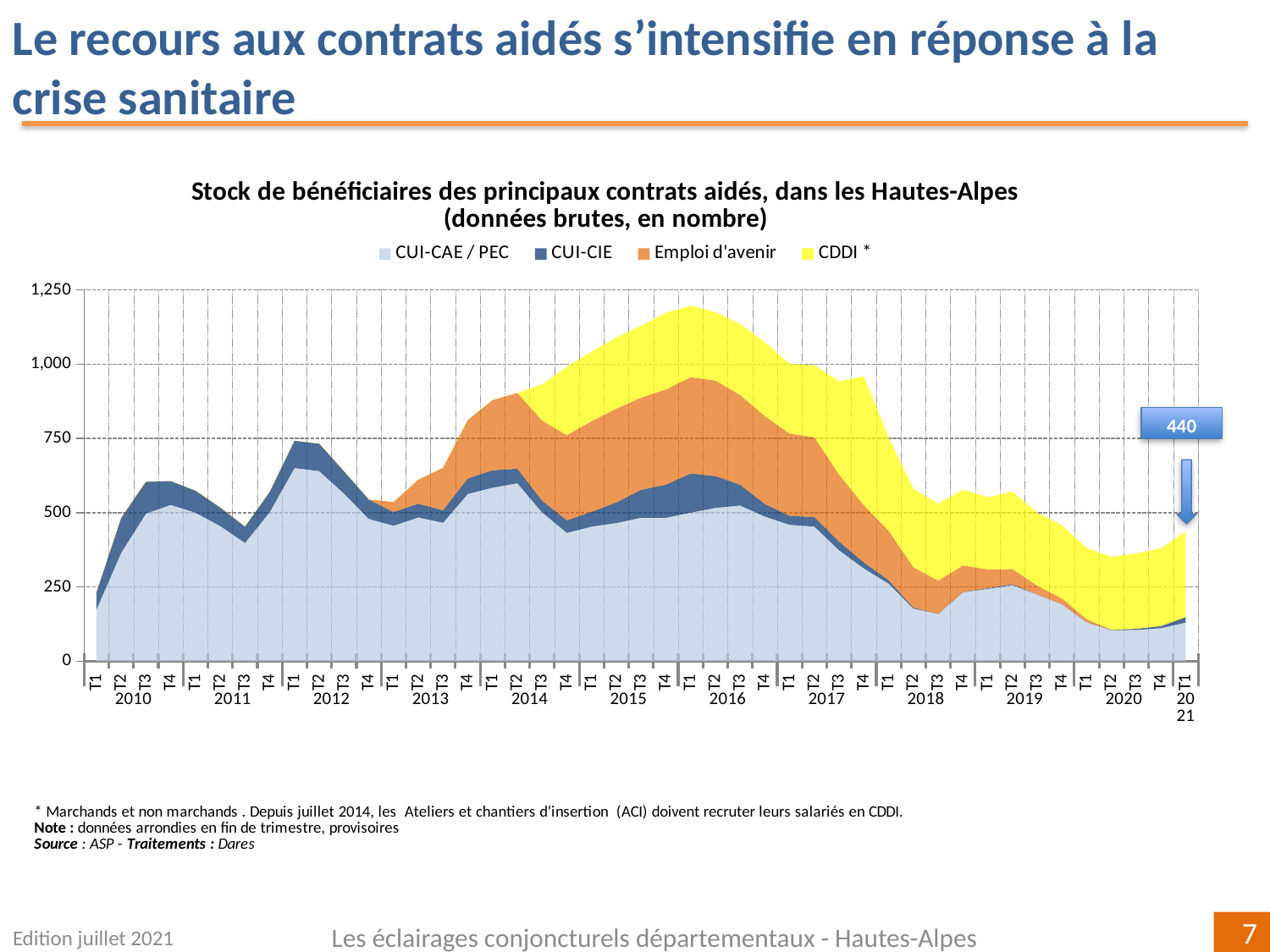
Which département does the chart title say the data refer to? Hautes-Alpes What is the total stock of beneficiaries shown by the data label for T1 2021? 440 How many years are labelled along the x axis of the chart? 12 In which year does the total stock of beneficiaries reach its highest level? 2016 Does the total stock of beneficiaries rise or fall between T1 2016 and T1 2020? fall Is the total stock of beneficiaries in T3 2020 greater or less than 500? less What kind of chart is shown on the slide? Stacked area chart How many series does the chart legend list? 4 Which series is shown in yellow in the chart? CDDI * Is the total stock of beneficiaries higher in T1 2016 or in T1 2021? T1 2016 Is the total stock of beneficiaries in T1 2016 greater or less than 1,000? greater